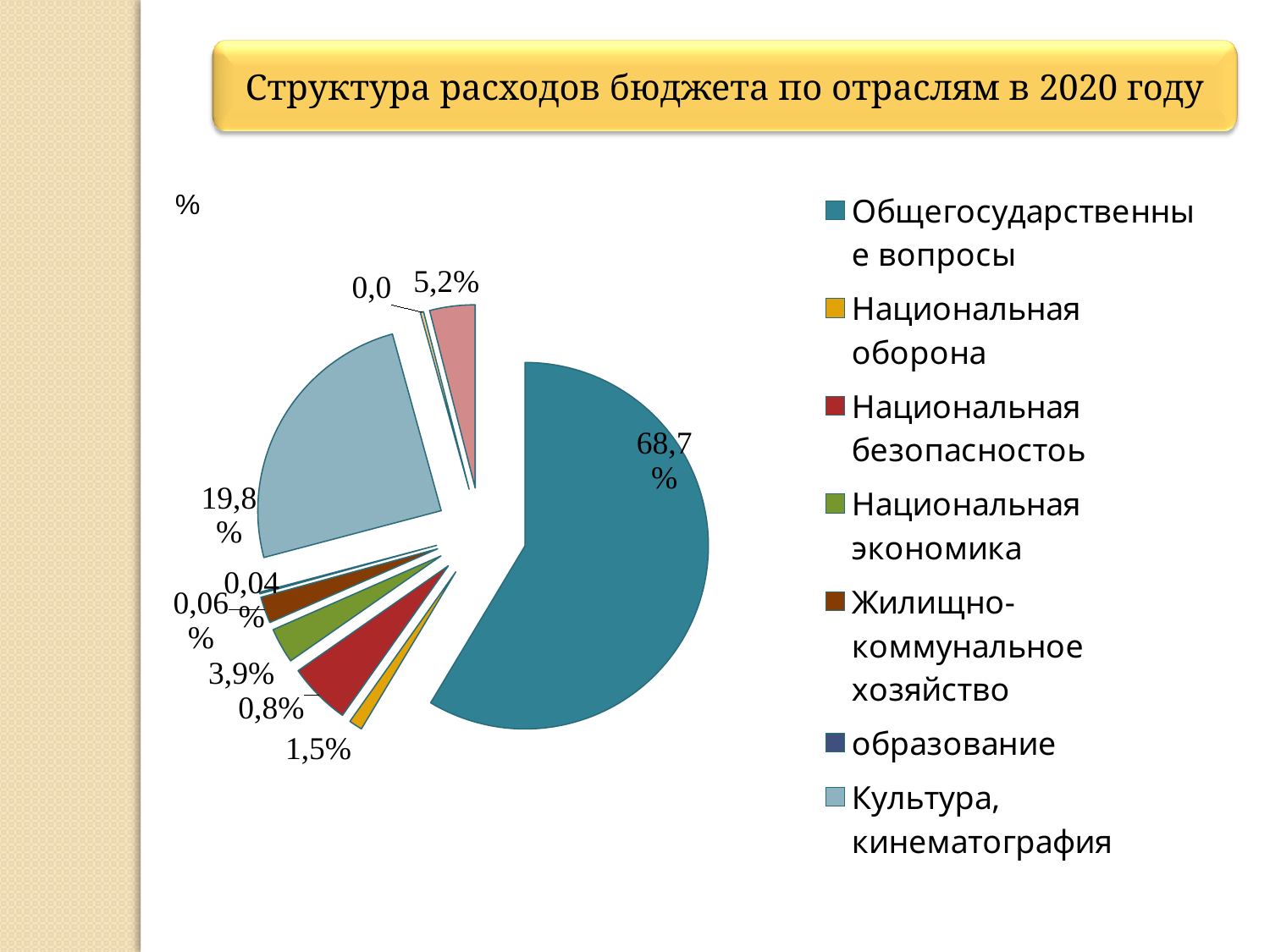
What share of the pie is labelled for Общегосударственные вопросы? 68,7% What colour is the slice for Общегосударственные вопросы in the legend? Teal (dark blue-green) What kind of chart is shown on the slide? Pie chart How many entries does the chart's legend list? 7 Which category has the largest slice of the pie? Общегосударственные вопросы What share of the pie is labelled for Культура, кинематография? 19,8% By how many percentage points does the share for Общегосударственные вопросы exceed the share for Культура, кинематография? 48,9 What is the title of the chart on the slide? Структура расходов бюджета по отраслям в 2020 году Which is larger: the slice for Культура, кинематография or the slice for Национальная оборона? Культура, кинематография Which is larger: the slice for Общегосударственные вопросы or the slice for Культура, кинематография? Общегосударственные вопросы What share of the pie is labelled for Национальная оборона? 1,5%